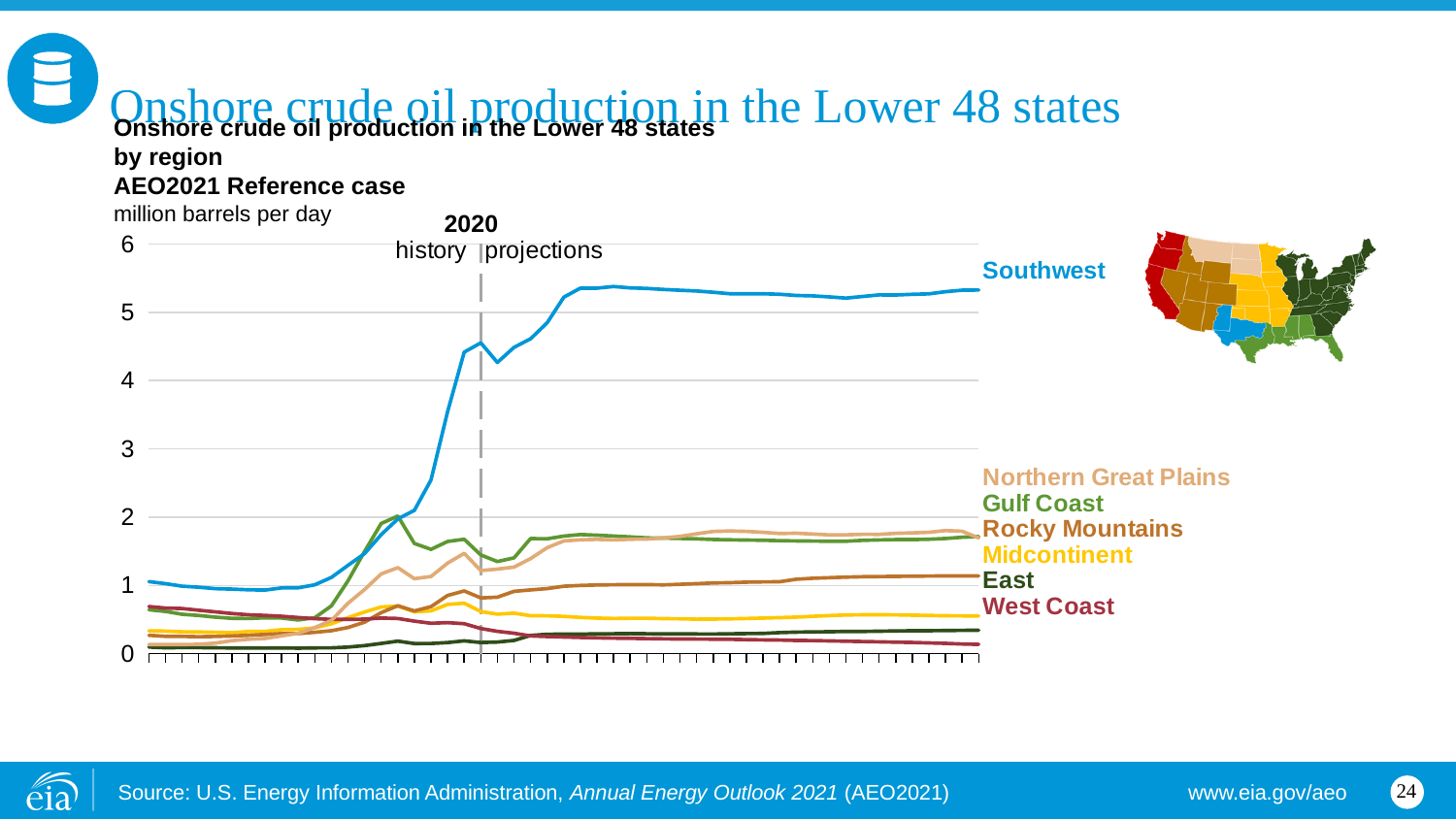
What unit is used on the chart's vertical axis? million barrels per day What kind of chart is shown on the slide? line chart At the end of the projection period, which is larger: East or West Coast production? East Which region has the highest onshore crude oil production at the end of the projection period? Southwest How many regions (series) are plotted on the chart? 7 Is the Northern Great Plains value at the end of the projection period greater or less than 1 million barrels per day? greater Is the Midcontinent value at the end of the projection period greater or less than 1 million barrels per day? less Is the Southwest value at the end of the projection period greater or less than 5 million barrels per day? greater Which region has the lowest onshore crude oil production at the end of the projection period? West Coast Does West Coast production rise or fall over the projection period? fall Does Southwest production rise or fall over the history period leading up to 2020? rise